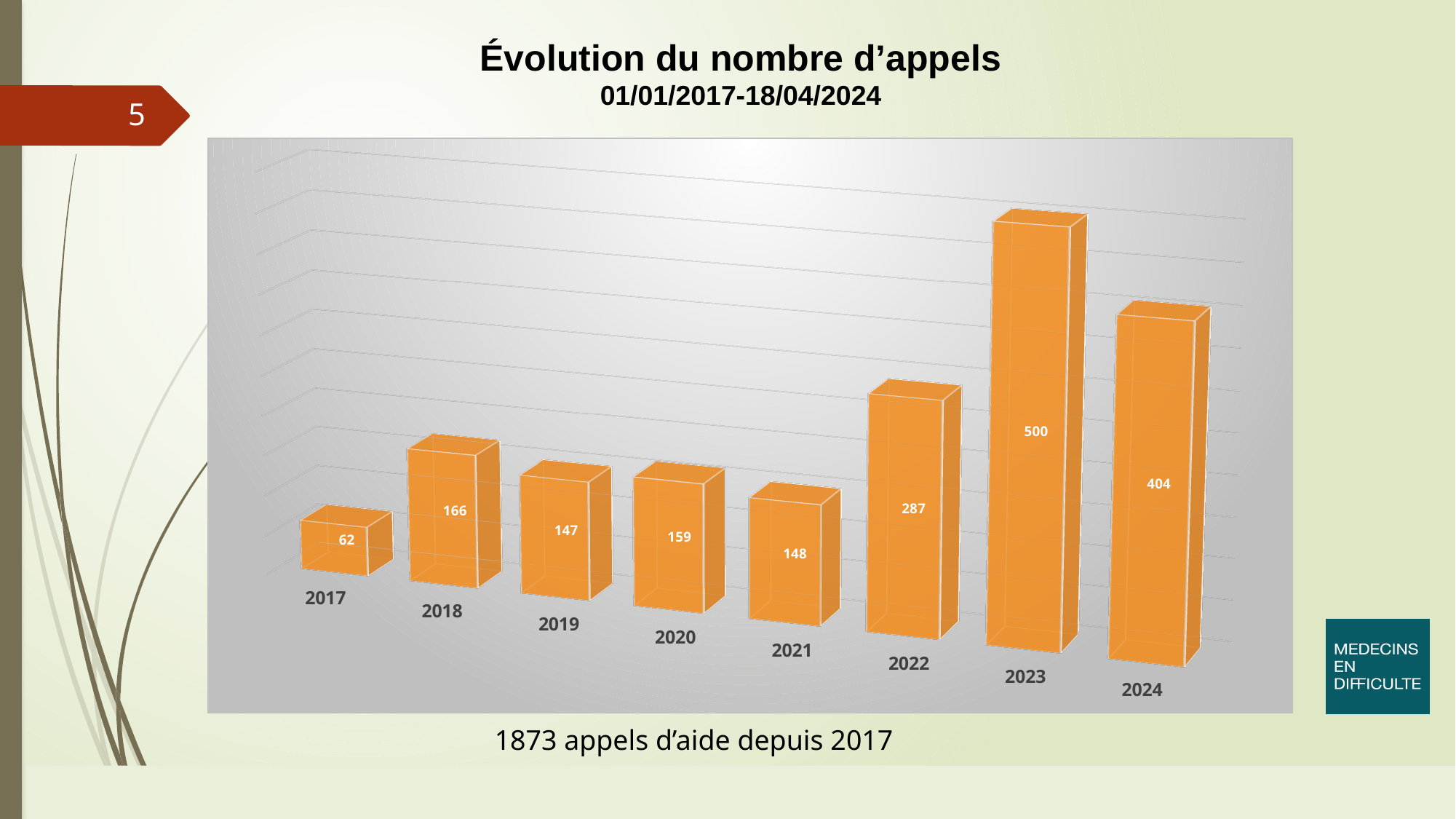
What is the difference between the number of calls in 2023 and in 2022? 213 What is the number of calls for 2022? 287 What kind of chart is shown on the slide? Bar chart Which year has the lowest number of calls? 2017 What is the number of calls for 2024? 404 What is the number of calls for 2017? 62 Which year has more calls, 2020 or 2021? 2020 How many years are shown on the chart? 8 Which year has more calls, 2024 or 2022? 2024 What is the title of the chart? Évolution du nombre d'appels What is the difference between the number of calls in 2018 and in 2017? 104 Which year has the highest number of calls? 2023